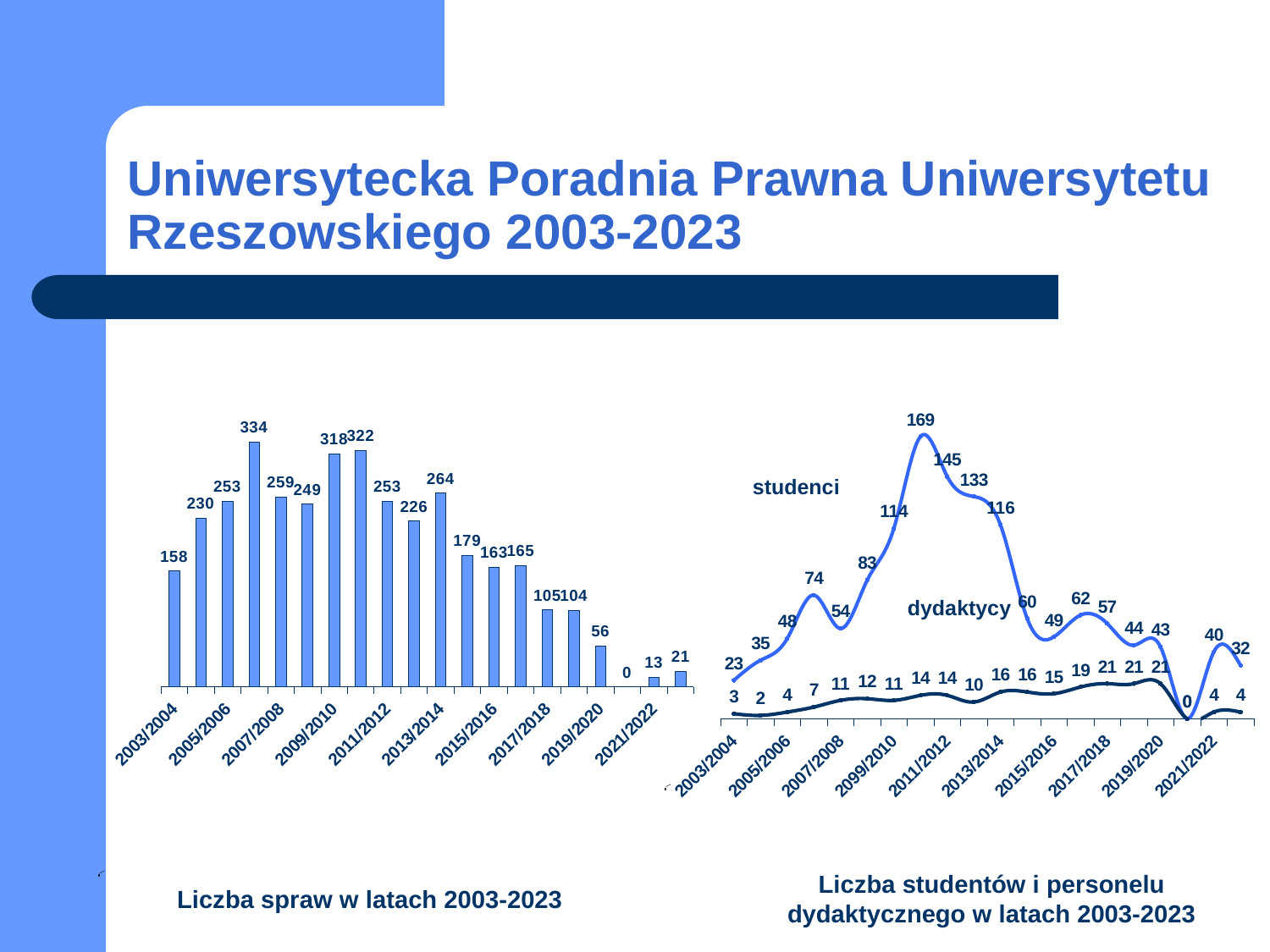
In the chart 'Liczba spraw w latach 2003-2023', what is the value for 2021/2022? 13 In the chart 'Liczba spraw w latach 2003-2023', how many bars are plotted? 20 In the chart 'Liczba spraw w latach 2003-2023', what is the value for 2003/2004? 158 In the chart 'Liczba spraw w latach 2003-2023', what is the lowest value shown? 0 What kind of chart is 'Liczba spraw w latach 2003-2023'? bar chart In the chart 'Liczba studentów i personelu dydaktycznego w latach 2003-2023', what is the value for dydaktycy in 2003/2004? 3 In the chart 'Liczba studentów i personelu dydaktycznego w latach 2003-2023', what is the value for studenci in 2003/2004? 23 How many series are plotted in the chart 'Liczba studentów i personelu dydaktycznego w latach 2003-2023'? 2 In the chart 'Liczba spraw w latach 2003-2023', what is the difference between the values for 2005/2006 and 2003/2004? 95 In the chart 'Liczba studentów i personelu dydaktycznego w latach 2003-2023', which series has the larger value in 2011/2012, studenci or dydaktycy? studenci In the chart 'Liczba studentów i personelu dydaktycznego w latach 2003-2023', what is the highest value for studenci? 169 In the chart 'Liczba spraw w latach 2003-2023', what is the highest value shown? 334